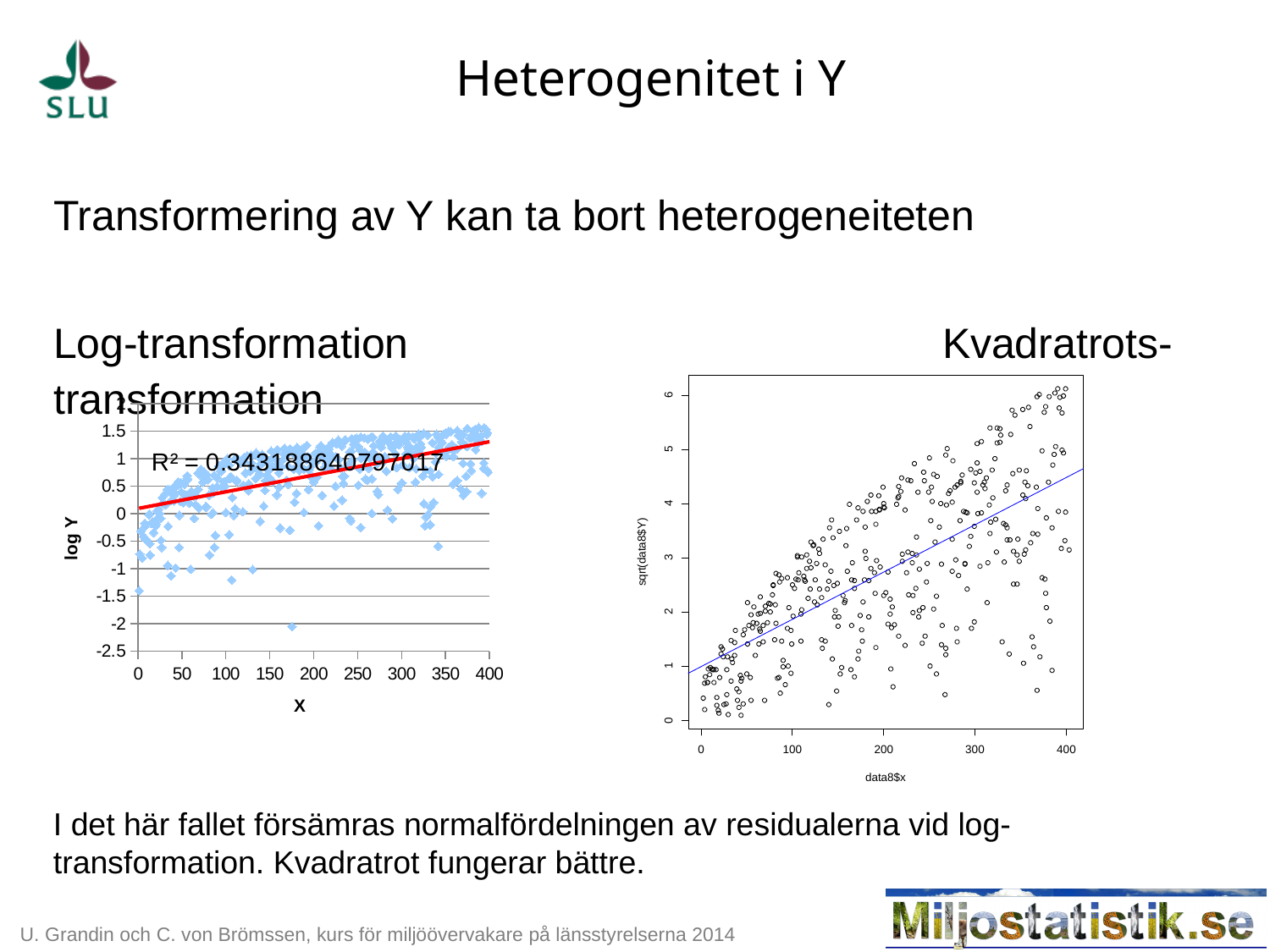
In the right chart (Kvadratrots-transformation), do the plotted values generally rise or fall as data8$x increases? rise In the left chart (Log-transformation), what is the highest value shown on the horizontal axis? 400 In the left chart (Log-transformation), is the lowest plotted point (near X = 175) greater or less than -1.5 on the log Y axis? less In the left chart (Log-transformation), what is the label of the horizontal axis? X What kind of chart is the left chart (Log-transformation)? scatter chart In the right chart (Kvadratrots-transformation), what is the highest tick value shown on the vertical axis? 6 In the right chart (Kvadratrots-transformation), what is the label of the horizontal axis? data8$x In the left chart (Log-transformation), what is the lowest value shown on the vertical axis? -2.5 In the left chart (Log-transformation), what is the label of the vertical axis? log Y In the left chart (Log-transformation), what R² value is printed on the chart? R² = 0.343188640797017 What kind of chart is the right chart (Kvadratrots-transformation)? scatter chart In the left chart (Log-transformation), do the plotted values generally rise or fall as X increases? rise